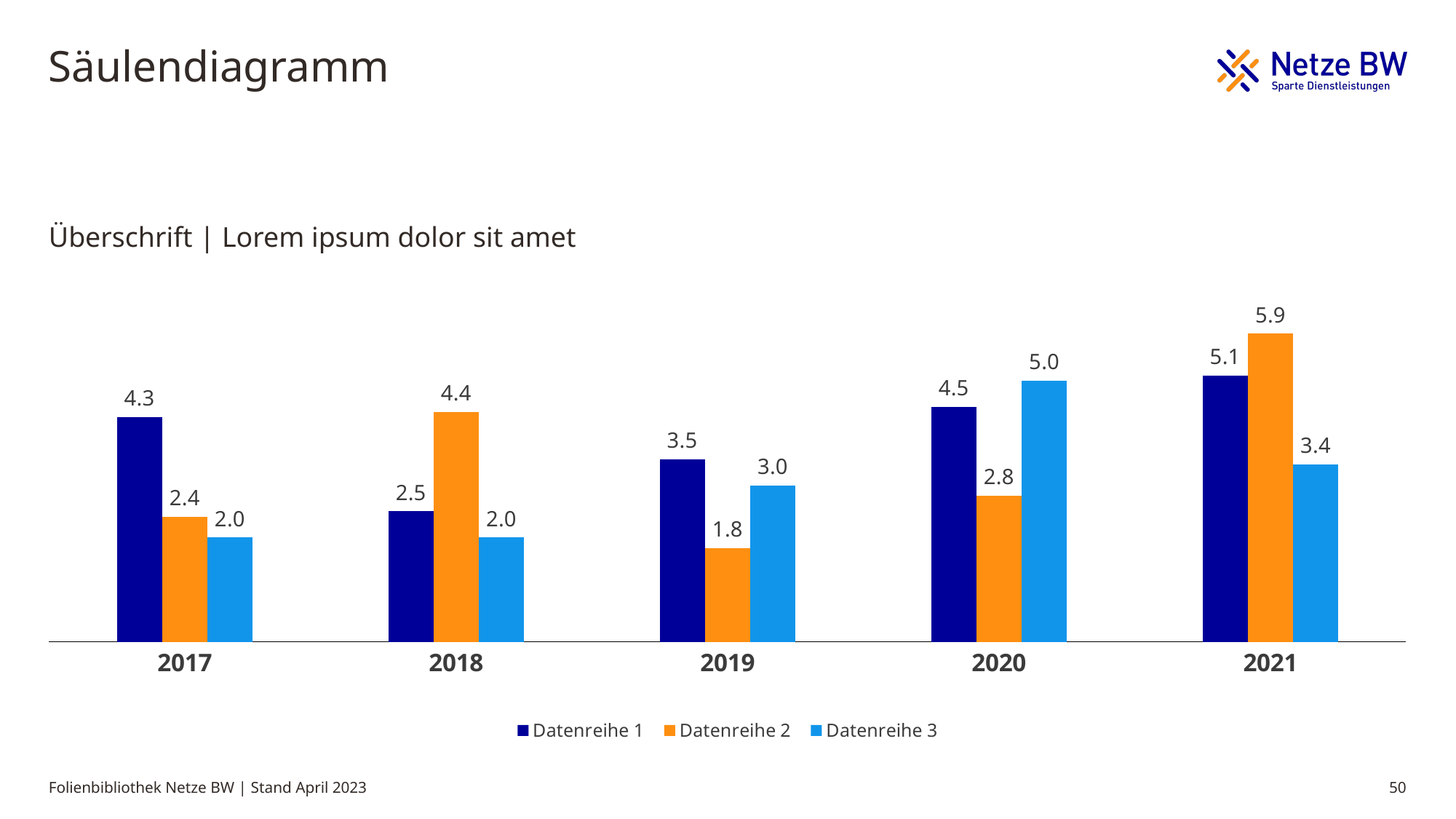
What colour are the bars for Datenreihe 2? Orange Which is larger in 2020, Datenreihe 1 or Datenreihe 3? Datenreihe 3 What kind of chart is shown on the slide? Bar chart What is the value of Datenreihe 1 in 2017? 4.3 In which year is Datenreihe 3 lowest? 2017 and 2018 Does Datenreihe 3 rise or fall from 2019 to 2020? Rise How many series does the legend list? 3 In which year is Datenreihe 2 highest? 2021 How many years are shown on the x axis? 5 What is the value of Datenreihe 2 in 2021? 5.9 What is the difference between Datenreihe 1 and Datenreihe 2 in 2018? 1.9 What is the value of Datenreihe 3 in 2019? 3.0